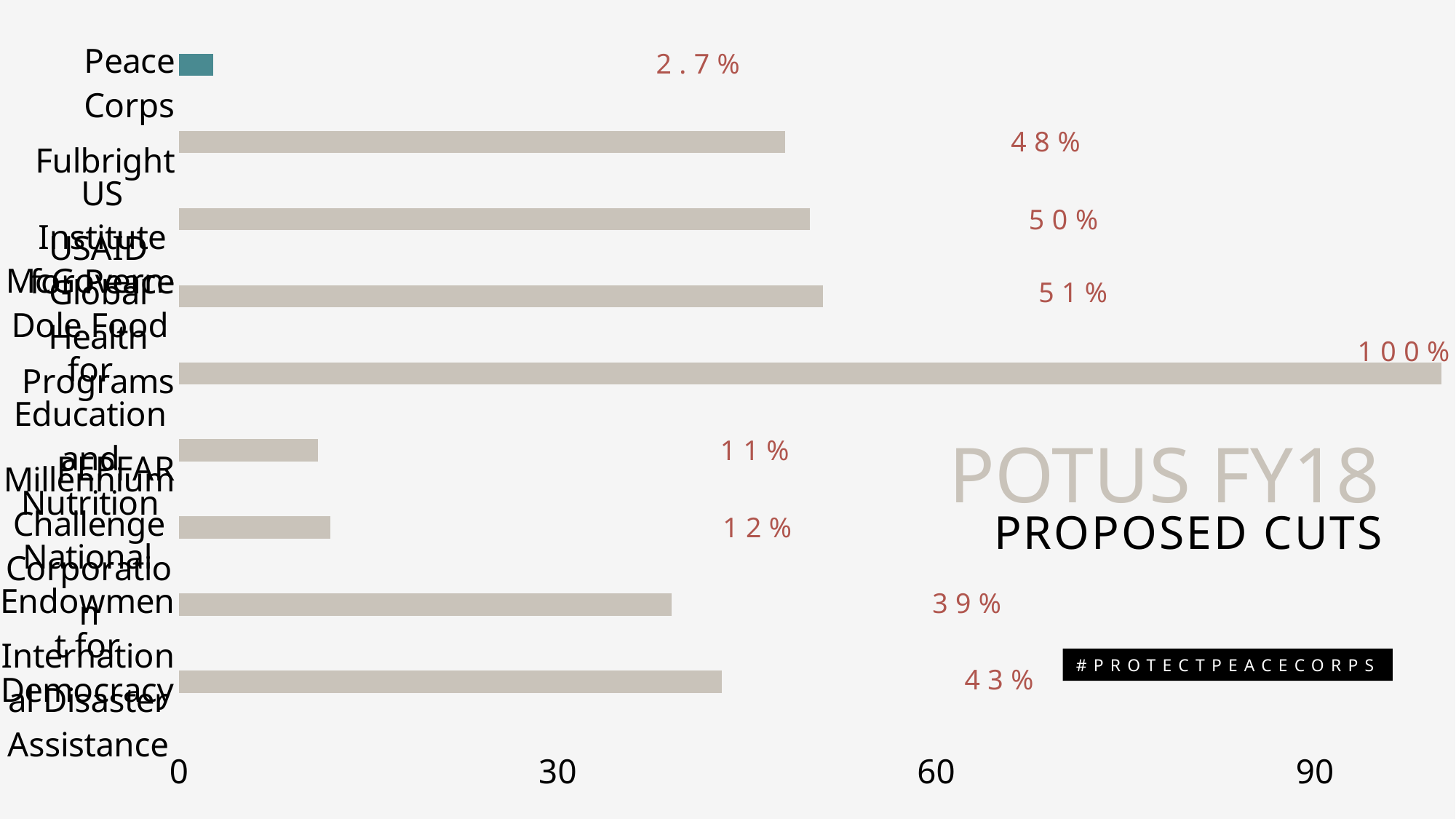
Which program has the smallest proposed cut? Peace Corps Which has a larger proposed cut, Fulbright or Millennium Challenge Corporation? Fulbright What is the proposed cut for Peace Corps? 2.7% What kind of chart is shown on the slide? Bar chart What is the proposed cut for National Endowment for Democracy? 39% What is the largest proposed cut value shown on the chart? 100% How many programs (bars) are shown on the chart? 9 What is the proposed cut for Fulbright? 48% What is the title of the chart? POTUS FY18 Proposed Cuts Is the value for Fulbright greater or less than 30? greater How much larger is the proposed cut for International Disaster Assistance than for National Endowment for Democracy? 4% What is the proposed cut for International Disaster Assistance? 43%